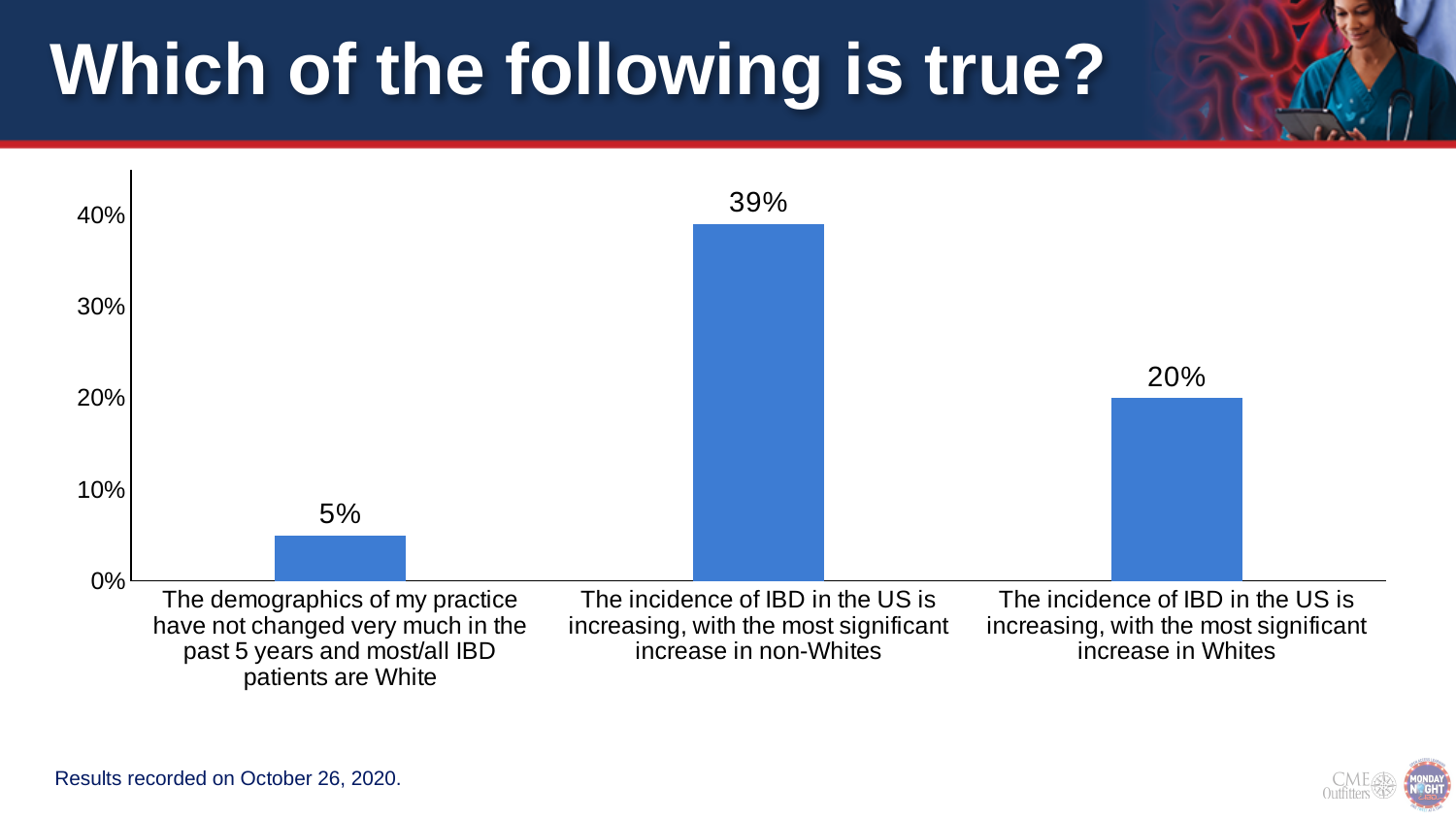
What percentage of respondents chose "The demographics of my practice have not changed very much in the past 5 years and most/all IBD patients are White"? 5% What percentage of respondents chose "The incidence of IBD in the US is increasing, with the most significant increase in Whites"? 20% Which received a larger share of responses: the "non-Whites" option or the "Whites" option? The incidence of IBD in the US is increasing, with the most significant increase in non-Whites What type of chart is shown on the slide? Bar chart On what date were the results shown in the chart recorded? October 26, 2020 What is the difference in percentage points between the "Whites" option and the "demographics of my practice have not changed" option? 15 How many response options are shown in the chart? 3 What percentage of respondents chose "The incidence of IBD in the US is increasing, with the most significant increase in non-Whites"? 39% Which response option received the highest percentage? The incidence of IBD in the US is increasing, with the most significant increase in non-Whites Is the value for the "non-Whites" option greater or less than 30%? greater Which response option received the lowest percentage? The demographics of my practice have not changed very much in the past 5 years and most/all IBD patients are White What is the difference in percentage points between the "non-Whites" option and the "Whites" option? 19